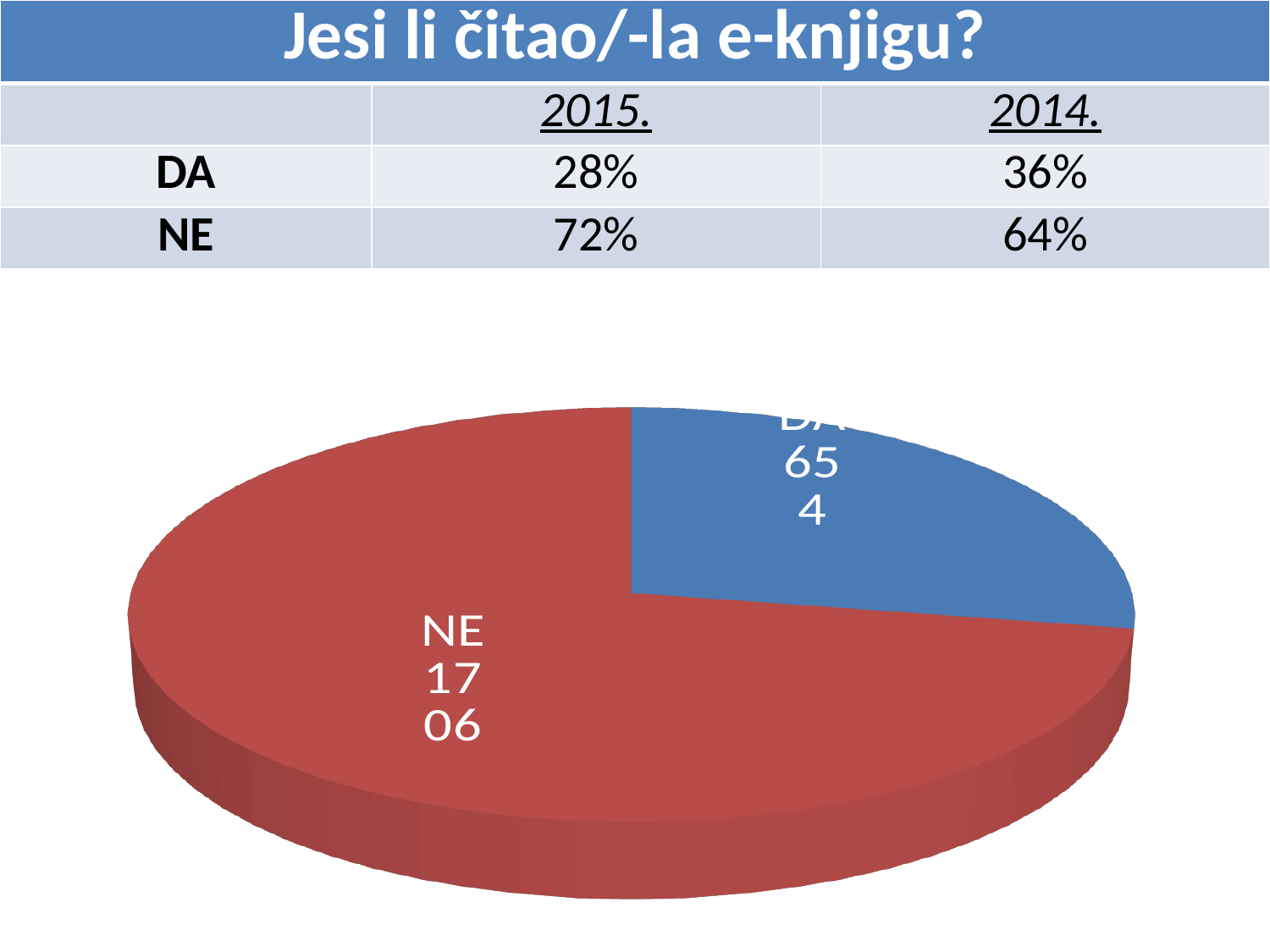
What share of the pie does the DA slice represent? 28% What colour is the NE slice in the pie chart? red How many slices does the pie chart have? 2 Which is larger in the pie chart, DA or NE? NE What is the total of the two values shown in the pie chart? 2360 Which category has the smallest slice in the pie chart? DA What is the difference between the NE and DA values in the pie chart? 1052 What is the value for DA in the pie chart? 654 What is the value for NE in the pie chart? 1706 What kind of chart is shown on the slide? pie chart Which category has the largest slice in the pie chart? NE What colour is the DA slice in the pie chart? blue